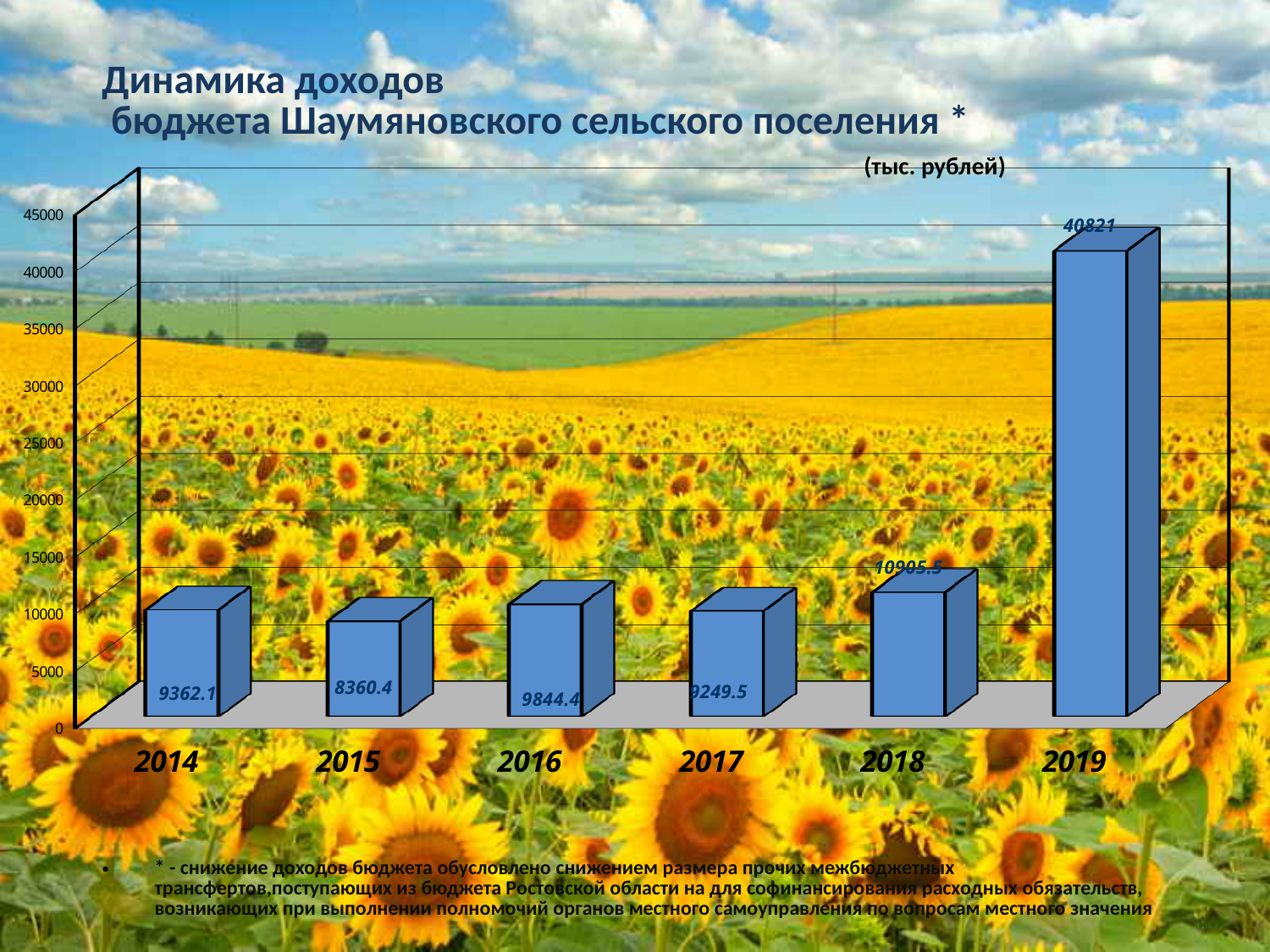
In what units are the values on the chart expressed, according to the label above the chart? тыс. рублей What is the value shown for 2018? 10905.5 What is the difference between the values for 2016 and 2015? 1484 What kind of chart is shown on the slide? bar chart What is the difference between the values for 2019 and 2018? 29915.5 Which is larger, the value for 2016 or the value for 2014? 2016 Is the value for 2018 greater or less than 15000? less How many years are shown on the x axis? 6 What is the value shown for 2015? 8360.4 Which year has the highest budget revenue? 2019 Which year has the lowest budget revenue? 2015 What is the budget revenue value shown for 2019? 40821